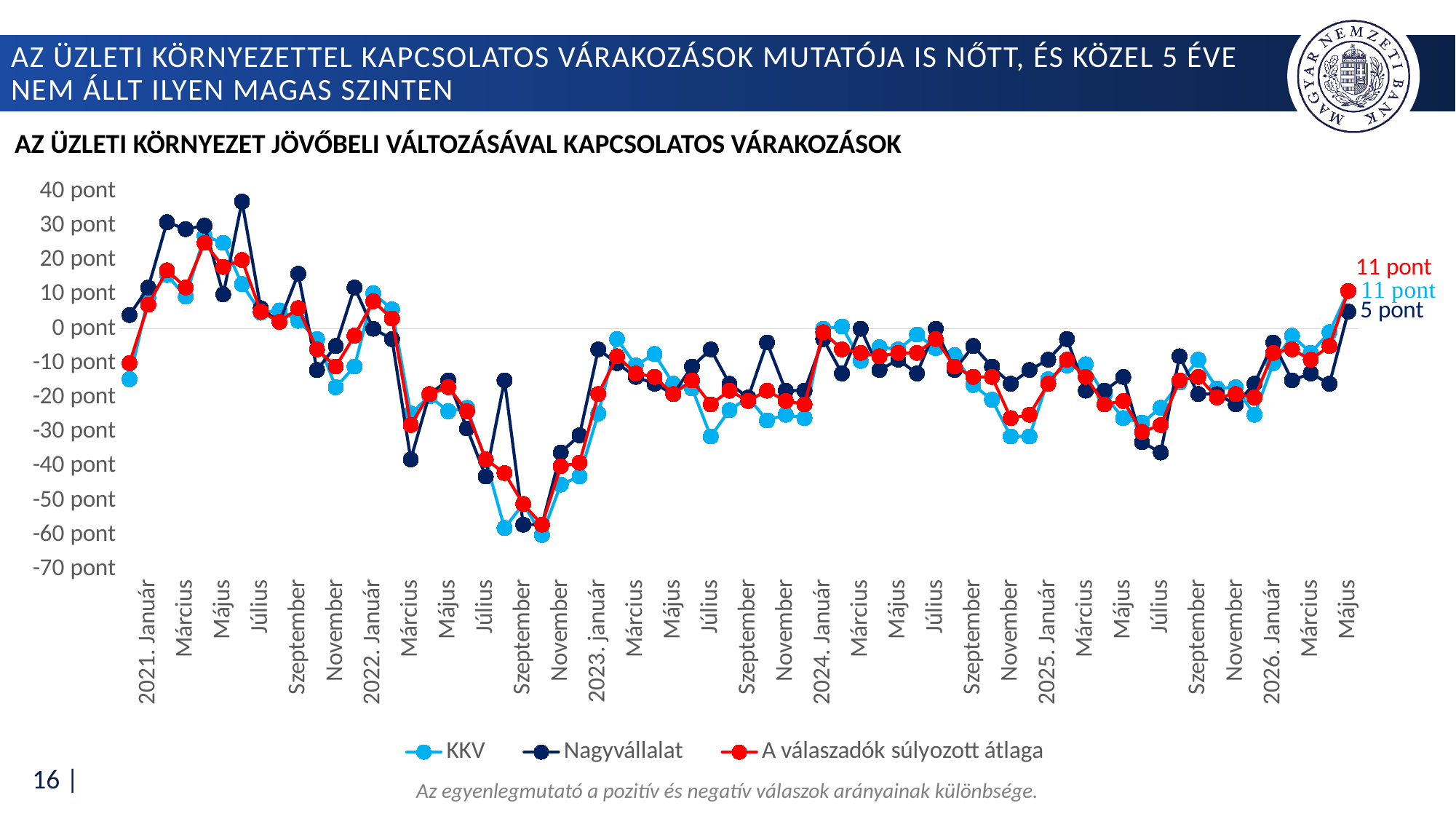
How many series does the legend list? 3 What is the value of 'A válaszadók súlyozott átlaga' at the last point (2026 Május)? 11 pont Do the values of the series rise or fall between 2026 Március and 2026 Május? rise At the last point (2026 Május), which is larger: the KKV value or the Nagyvállalat value? KKV At the last point (2026 Május), what is the difference between the KKV value and the Nagyvállalat value? 6 pont What is the value of the Nagyvállalat series at the last point (2026 Május)? 5 pont What kind of chart is shown on the slide? line chart Which series has the lowest value at the last point (2026 Május)? Nagyvállalat Which series is drawn in red? A válaszadók súlyozott átlaga What is the value of the KKV series at the last point (2026 Május)? 11 pont Is the highest value of the Nagyvállalat series (around 2021 Május) greater or less than 30 pont? greater